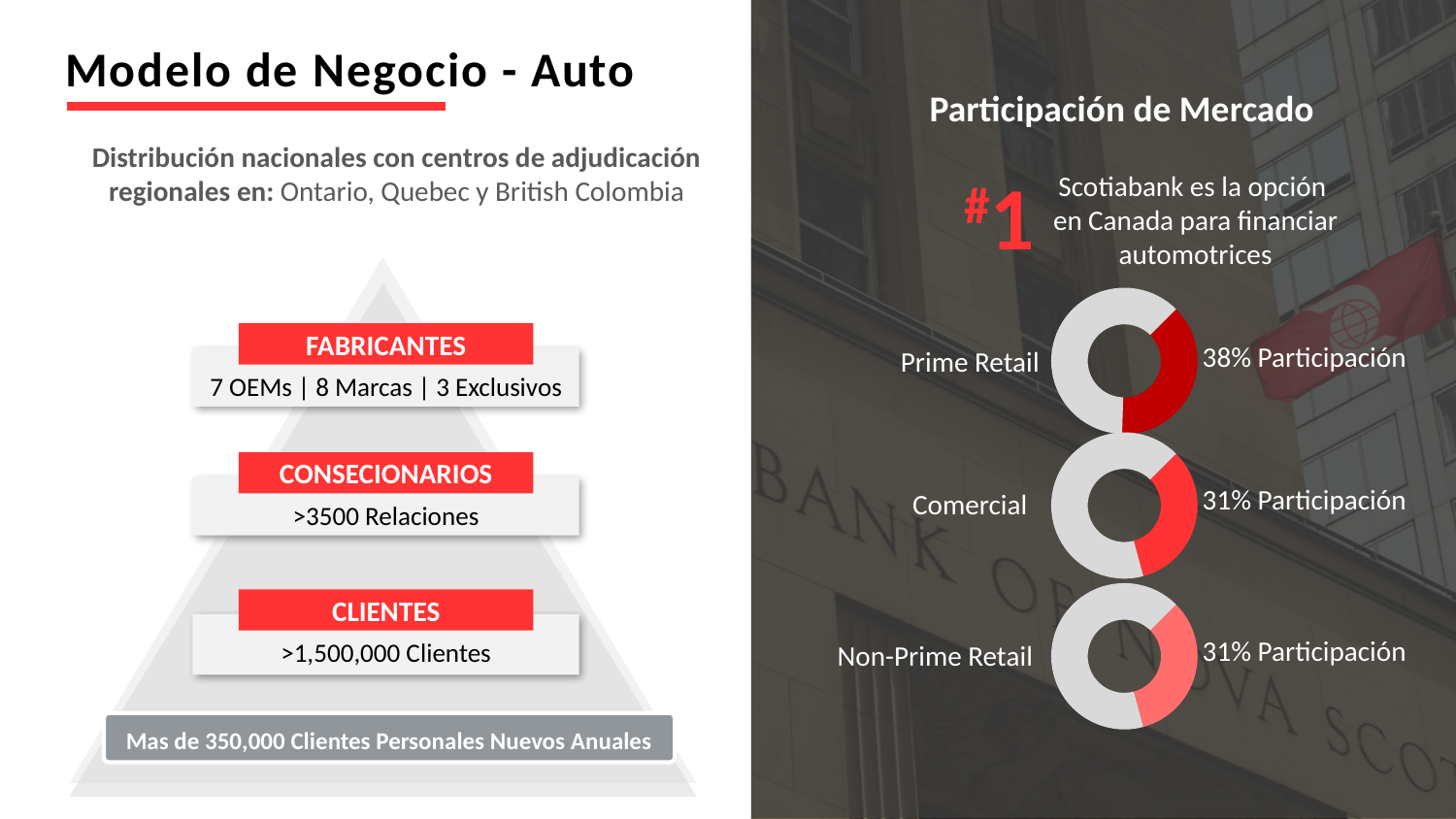
How many donut charts are shown under Participación de Mercado? 3 What is the market share shown in the Prime Retail donut chart? 38% Participación What kind of chart is used to show each market share under Participación de Mercado? Donut (pie) chart Which segment is labelled on the topmost donut chart? Prime Retail In the Prime Retail donut chart, what share of the ring is filled in red? 38% Which is larger, the Prime Retail share or the Non-Prime Retail share? Prime Retail Is the Prime Retail share greater or less than 50%? less What is the market share shown in the Comercial donut chart? 31% Participación Which of the three donut charts under Participación de Mercado shows the highest share? Prime Retail What is the market share shown in the Non-Prime Retail donut chart? 31% Participación What is the title above the three donut charts? Participación de Mercado What is the difference between the Prime Retail share and the Comercial share? 7%